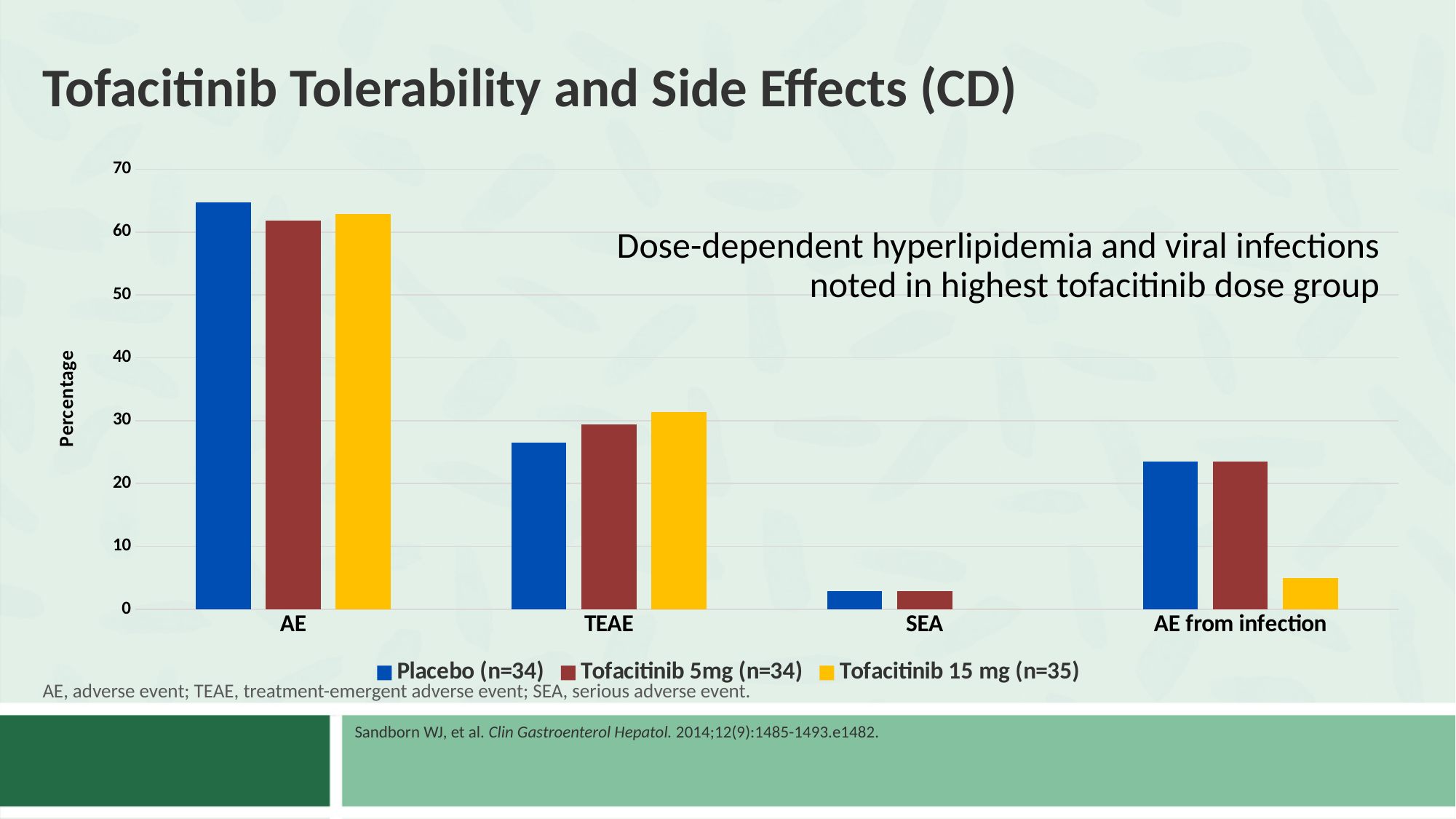
Which category has the lowest values across all three series? SEA In the AE from infection category, which is larger: Placebo (n=34) or Tofacitinib 15 mg (n=35)? Placebo (n=34) Is the value for Tofacitinib 15 mg (n=35) in the TEAE category greater or less than 30? greater Is the value for Placebo (n=34) in the AE category greater or less than 60? greater What kind of chart is shown on the slide? bar chart In the TEAE category, which is larger: Placebo (n=34) or Tofacitinib 15 mg (n=35)? Tofacitinib 15 mg (n=35) Is the value for Placebo (n=34) in the TEAE category greater or less than 30? less How many series does the legend list? 3 Which category has the highest values across all three series? AE What is the label of the y axis? Percentage How many categories are shown on the x axis? 4